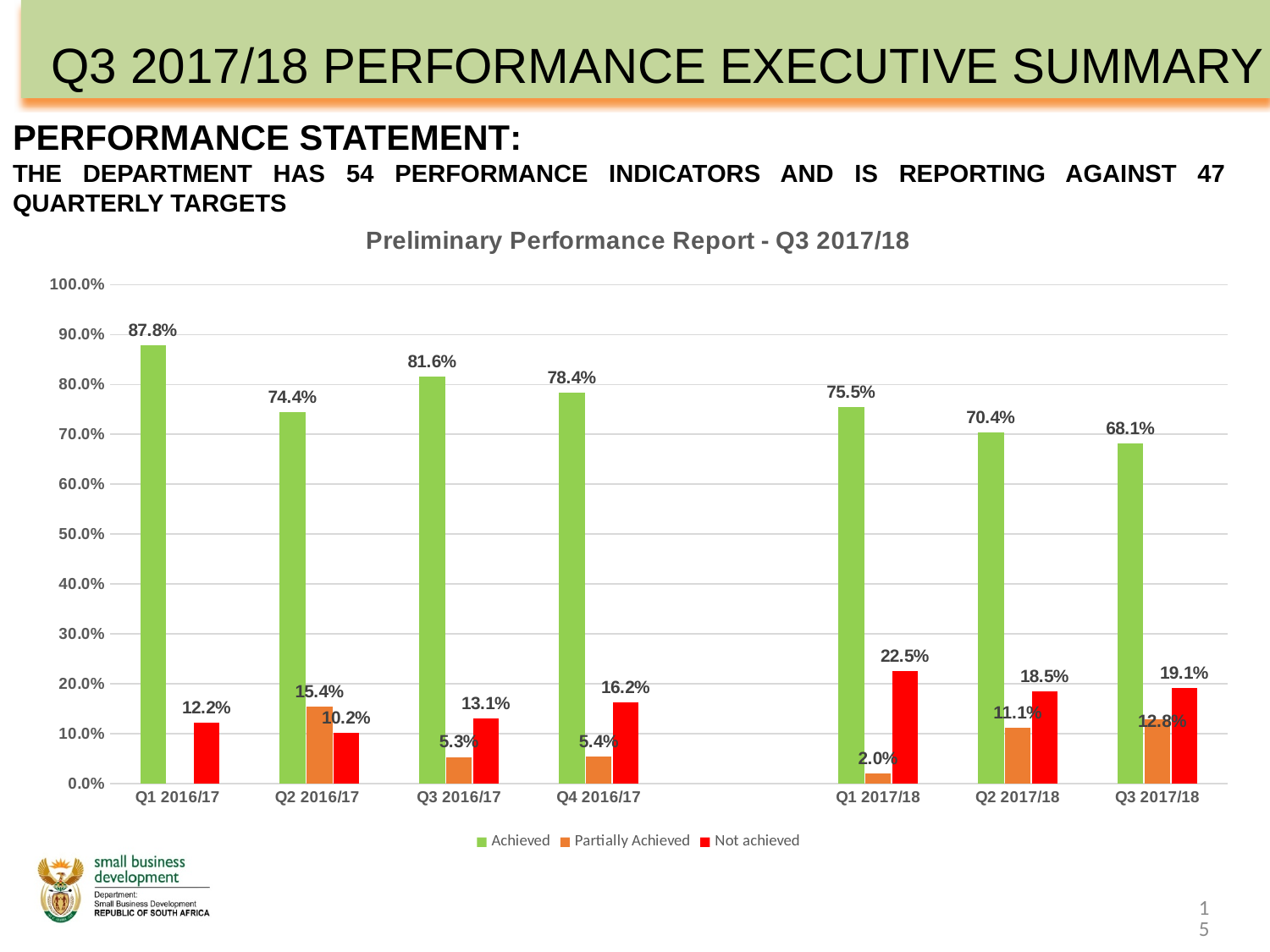
Do the Achieved values rise or fall from Q1 2017/18 to Q3 2017/18? fall Which is larger, the Not achieved value for Q2 2017/18 or for Q3 2017/18? Q3 2017/18 Which quarter has the highest Not achieved value? Q1 2017/18 How many series does the legend list? 3 Which quarter has the highest Achieved value? Q1 2016/17 How many quarters are shown on the x axis? 7 What is the difference between the Achieved value for Q1 2016/17 and the Achieved value for Q3 2017/18? 19.7% What is the Not achieved value for Q4 2016/17? 16.2% What is the Partially Achieved value for Q1 2017/18? 2.0% Which quarter has the lowest Achieved value? Q3 2017/18 Is the Achieved value for Q2 2016/17 greater or less than 80.0%? less What is the Achieved value for Q3 2017/18? 68.1%